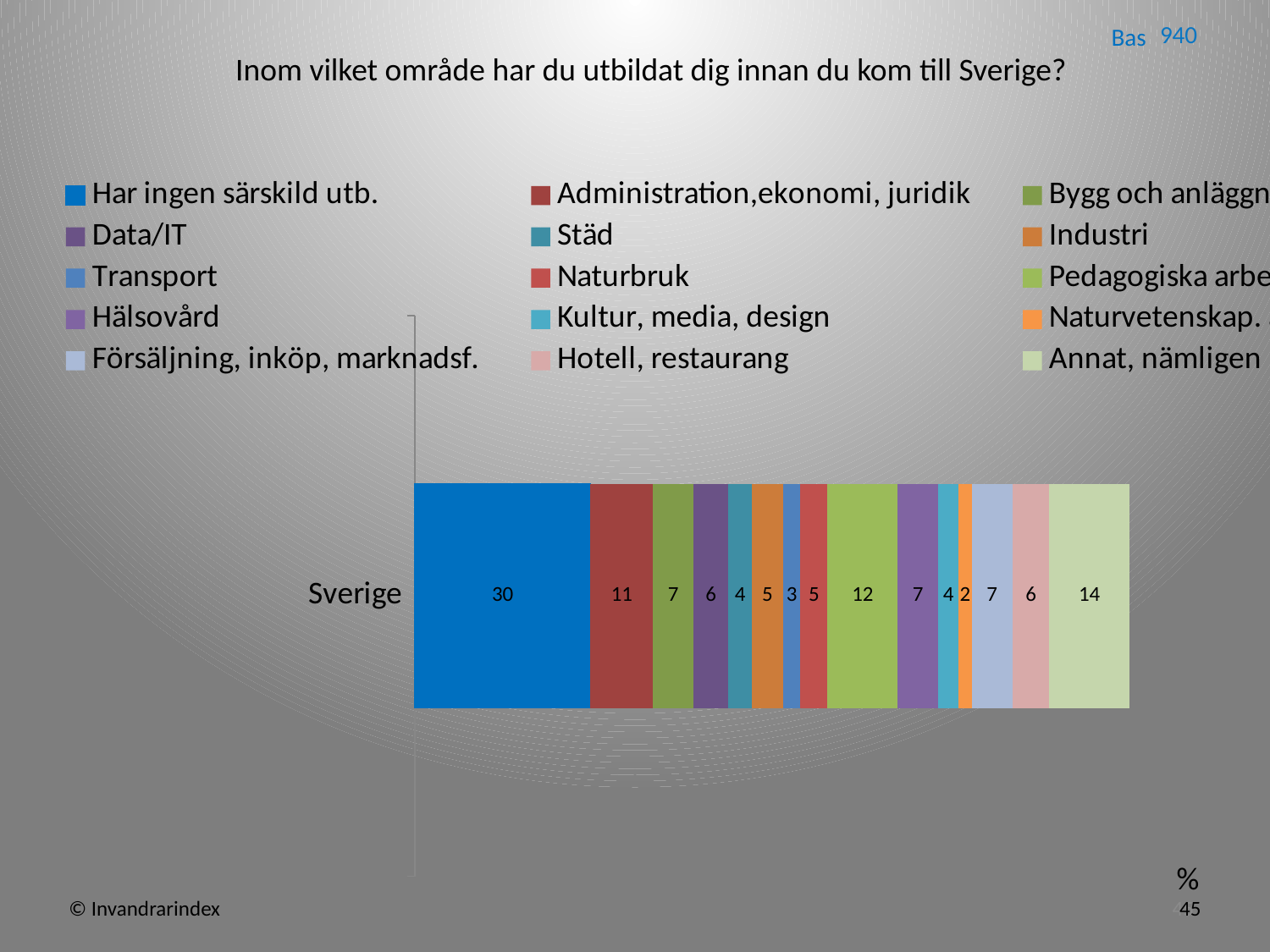
Which series has the smallest segment in the Sverige bar? Naturvetenskap. How many categories are plotted on the y axis? 1 What is the value for Har ingen särskild utb. in the Sverige bar? 30 Which is larger, the value for Pedagogiska arbete or the value for Administration,ekonomi, juridik? Pedagogiska arbete What is the value for Administration,ekonomi, juridik in the Sverige bar? 11 What is the total of all segments in the Sverige bar? 123 How many series does the legend list? 15 What is the difference between the values for Har ingen särskild utb. and Annat, nämligen? 16 Which series has the largest segment in the Sverige bar? Har ingen särskild utb. What kind of chart is shown on the slide? Stacked bar chart What is the value for Pedagogiska arbete in the Sverige bar? 12 What is the value for Annat, nämligen in the Sverige bar? 14